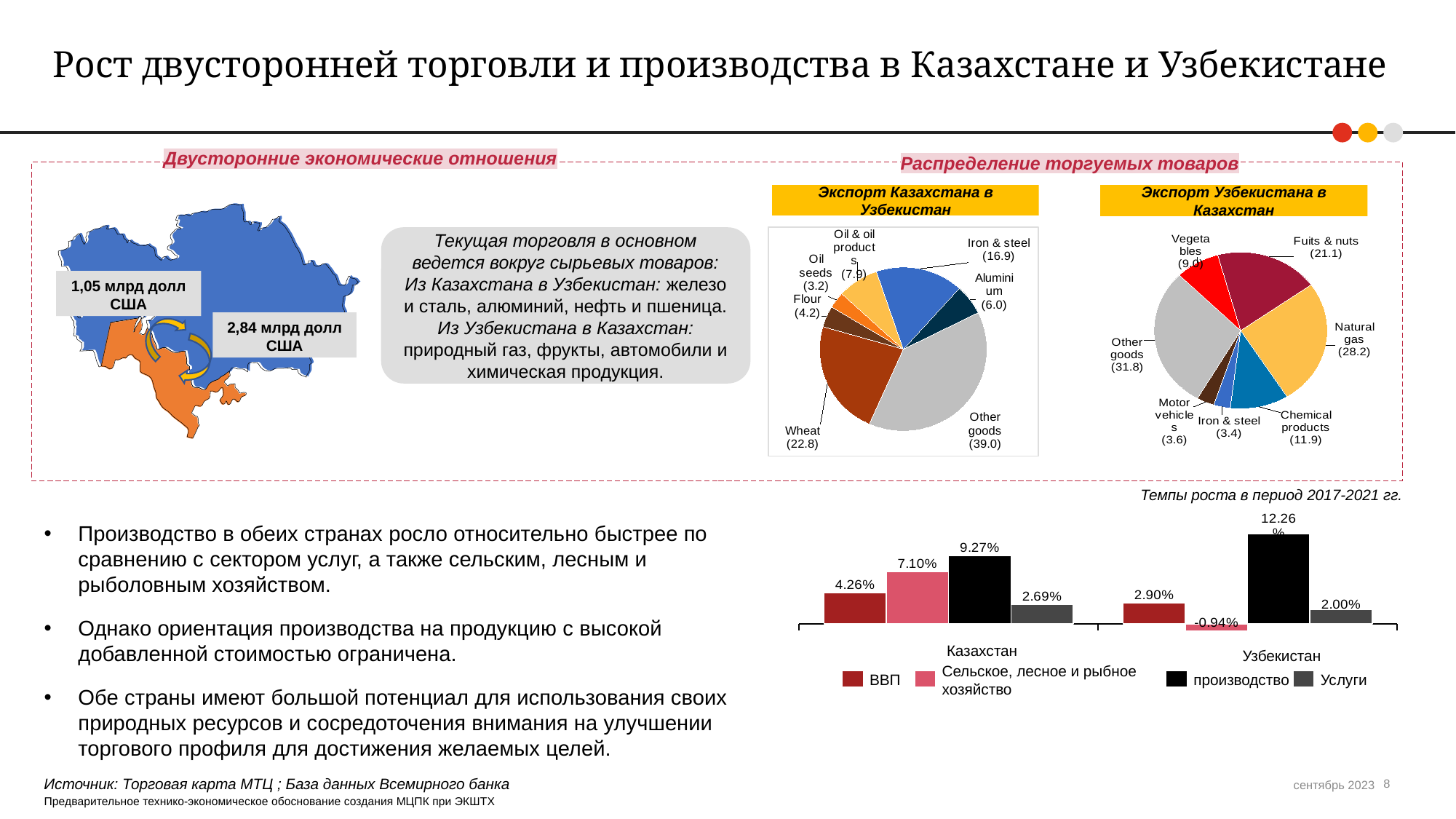
In the bar chart 'Темпы роста в период 2017-2021 гг.', what is the value for производство in Узбекистан? 12.26% In the pie chart 'Экспорт Казахстана в Узбекистан', which category has the largest slice? Other goods How many series does the legend of the bar chart 'Темпы роста в период 2017-2021 гг.' list? 4 In the bar chart 'Темпы роста в период 2017-2021 гг.', what is the value for Сельское, лесное и рыбное хозяйство in Узбекистан? -0.94% What type of chart is 'Темпы роста в период 2017-2021 гг.'? Bar chart How many categories are shown in the pie chart 'Экспорт Узбекистана в Казахстан'? 7 In the pie chart 'Экспорт Узбекистана в Казахстан', what is the value for Natural gas? 28.2 In the bar chart 'Темпы роста в период 2017-2021 гг.', what is the difference between производство and Услуги for Казахстан? 6.58% In the pie chart 'Экспорт Казахстана в Узбекистан', what is the difference between Iron & steel and Aluminium? 10.9 In the pie chart 'Экспорт Узбекистана в Казахстан', which is larger: Fuits & nuts or Chemical products? Fuits & nuts In the pie chart 'Экспорт Казахстана в Узбекистан', what is the value for Wheat? 22.8 In the pie chart 'Экспорт Казахстана в Узбекистан', which category has the smallest slice? Oil seeds